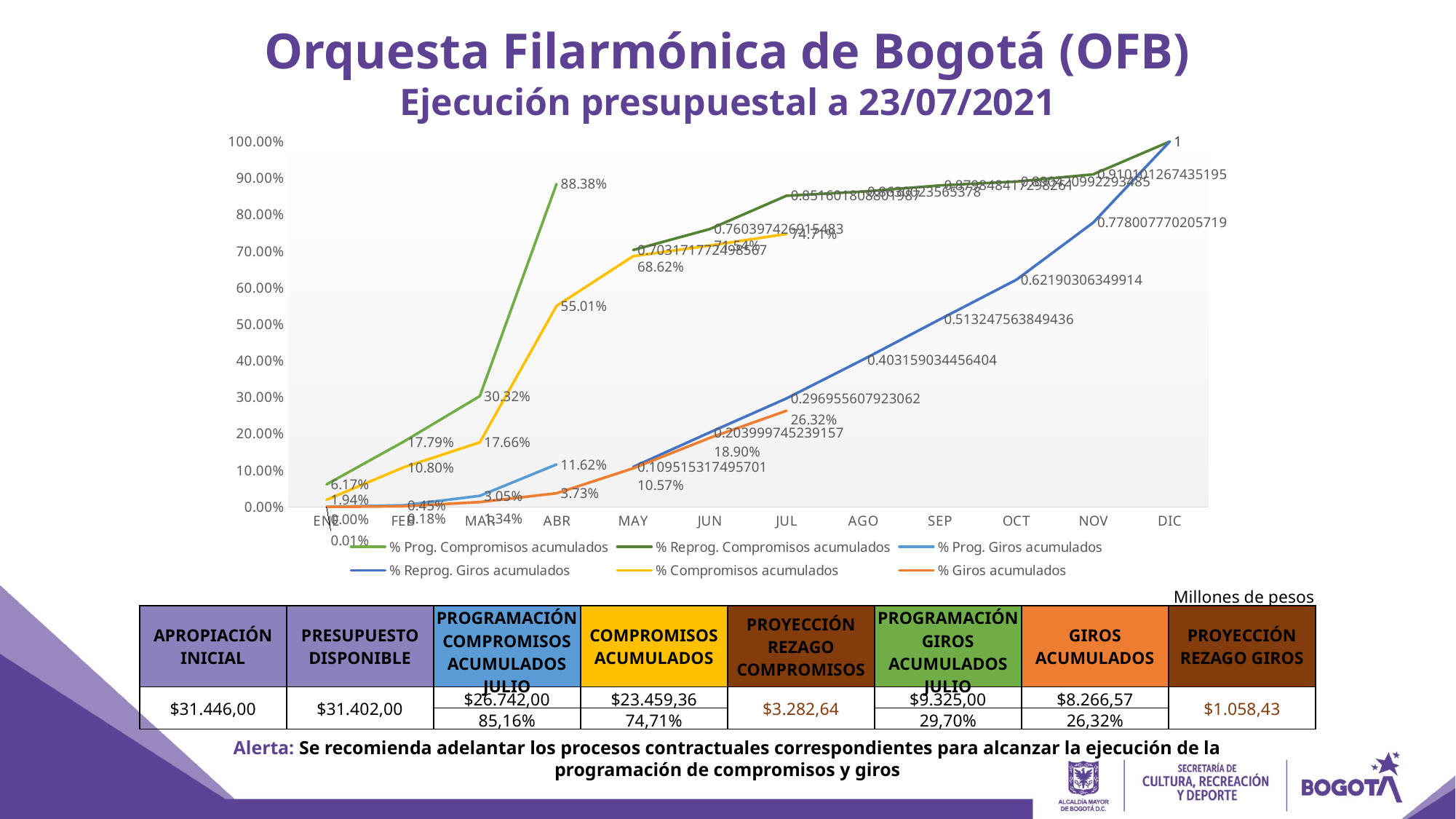
How many series does the chart's legend list? 6 In MAR, which is larger: % Prog. Compromisos acumulados or % Compromisos acumulados? % Prog. Compromisos acumulados Does % Giros acumulados rise or fall from ENE to JUL? rise What is the value of % Compromisos acumulados in JUL? 74.71% How many months are shown along the x axis of the chart? 12 What kind of chart is shown on the slide? line chart Which series in the chart is drawn in orange? % Giros acumulados What is the value of % Prog. Compromisos acumulados in ABR? 88.38% Is the value for % Reprog. Giros acumulados in OCT greater or less than 60%? greater What is the value of % Prog. Giros acumulados in ABR? 11.62% What is the value of % Giros acumulados in JUL? 26.32% What is the difference between % Prog. Compromisos acumulados and % Compromisos acumulados in ABR? 33.37%